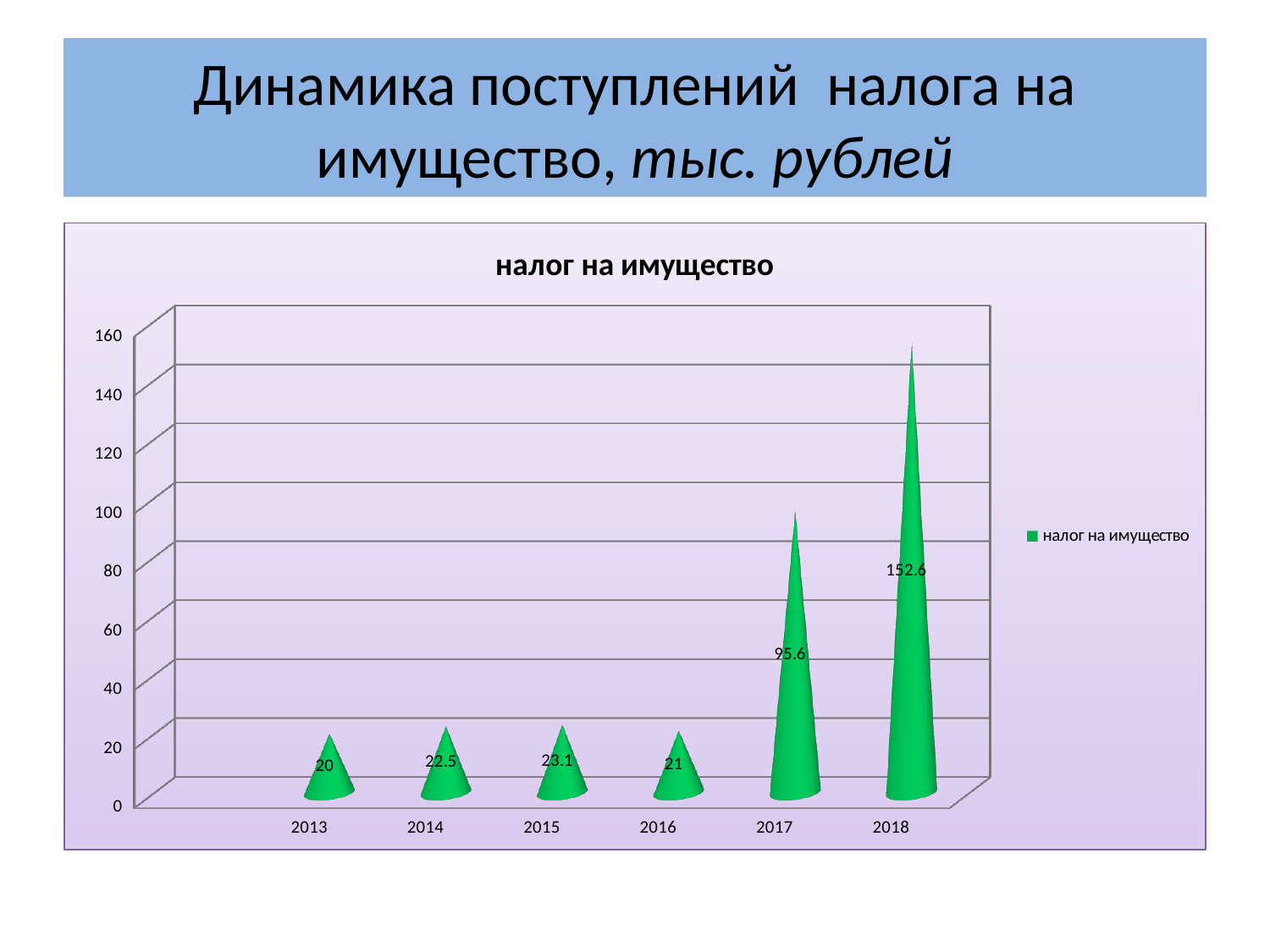
Which year has the highest value? 2018 How many years are shown on the x axis? 6 Which is larger, the value for 2014 or the value for 2016? 2014 What is the value for 2017? 95.6 Which year has the lowest value? 2013 What is the difference between the values for 2018 and 2017? 57 What is the title of the chart? налог на имущество What is the value for 2015? 23.1 How many series does the legend list? 1 What kind of chart is shown? bar chart What is the value for 2018? 152.6 What is the value for 2013? 20